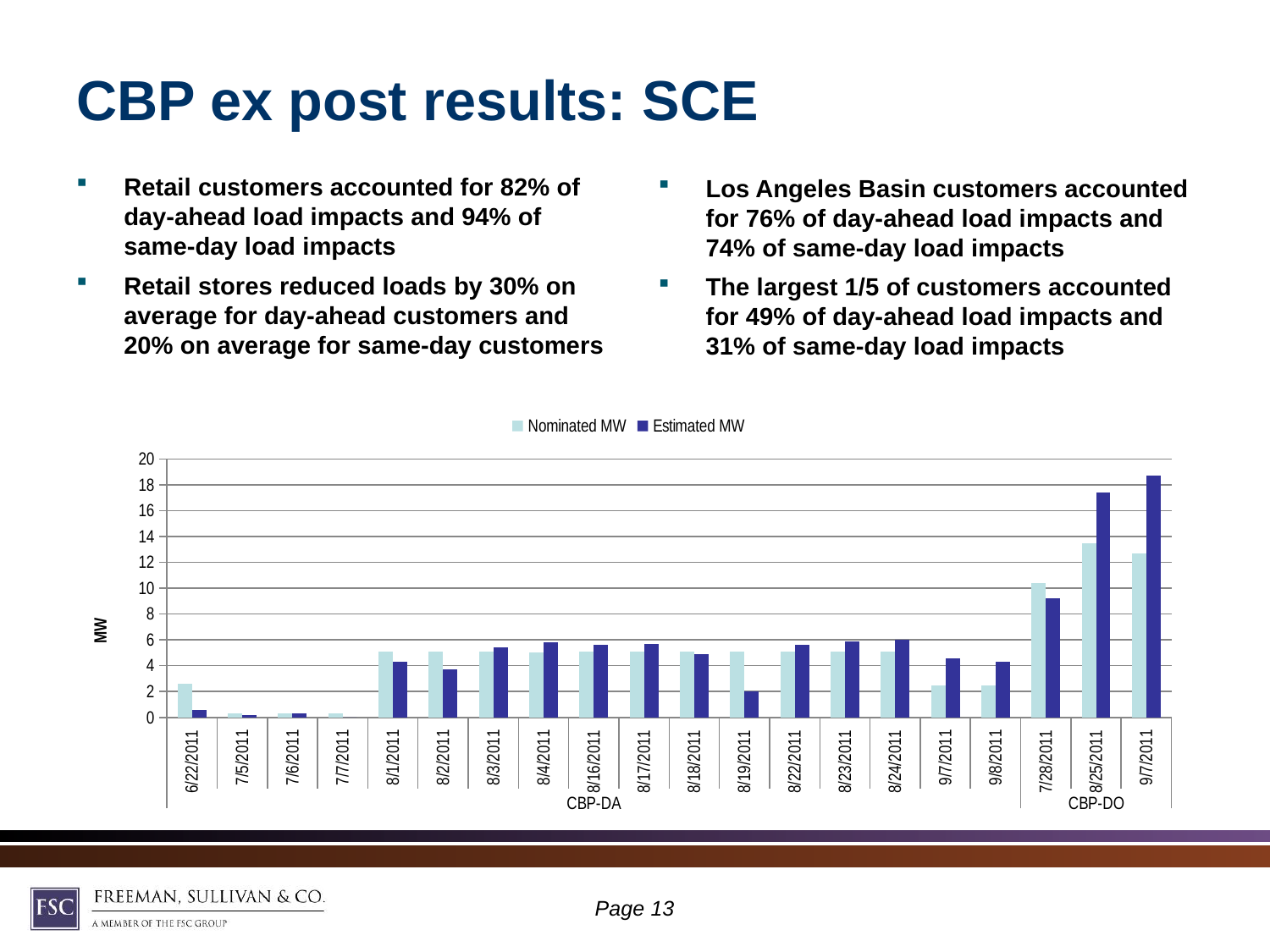
Is the Estimated MW value for 8/19/2011 greater or less than 4? less What are the two series named in the chart legend? Nominated MW and Estimated MW How many series does the chart legend list? 2 How many dates are shown on the x axis of the chart in total? 20 For 8/19/2011, which is larger: Nominated MW or Estimated MW? Nominated MW For 8/25/2011, which is larger: Nominated MW or Estimated MW? Estimated MW Which date has the highest Nominated MW value? 8/25/2011 How many dates are grouped under CBP-DO on the x axis? 3 What is the label on the vertical axis of the chart? MW Which date has the highest Estimated MW value? 9/7/2011 (CBP-DO) Is the Estimated MW value for 9/7/2011 under CBP-DO greater or less than 18? greater What type of chart is shown on the slide? Bar chart